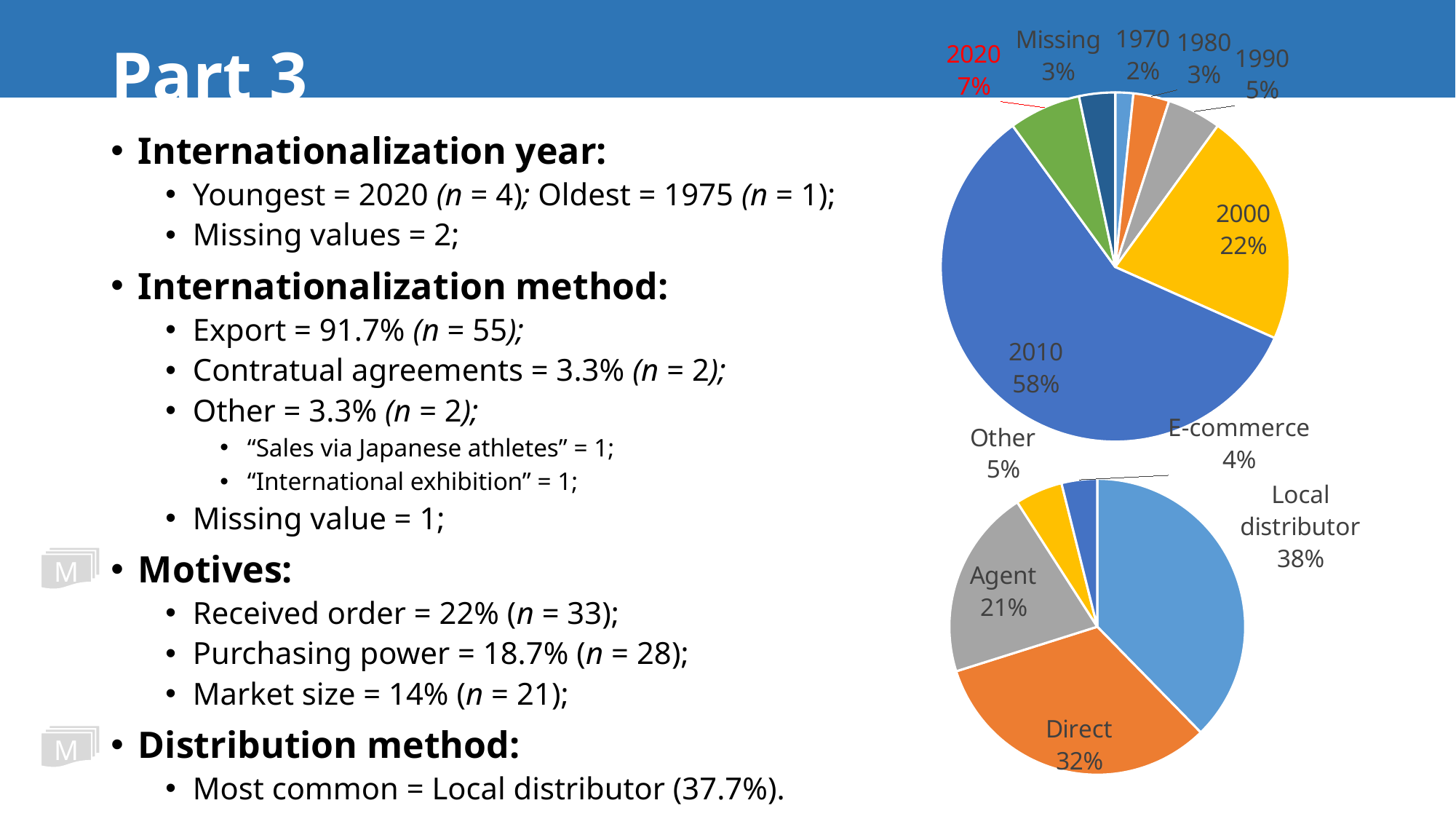
In the top pie chart, which slice is the largest? 2010 In the top pie chart, what share is labelled for 2010? 58% What kind of chart is the bottom chart? Pie chart In the top pie chart, which slice is the smallest? 1970 In the bottom pie chart, what share is labelled for Local distributor? 38% In the bottom pie chart, what share is labelled for Agent? 21% In the top pie chart, what is the difference between the shares for 2010 and 2000? 36% In the top pie chart, what share is labelled for 2020? 7% In the top pie chart, how many slices are there? 7 In the bottom pie chart, which slice is the largest? Local distributor In the bottom pie chart, which is larger, Direct or Agent? Direct In the top pie chart, what share is labelled for 2000? 22%